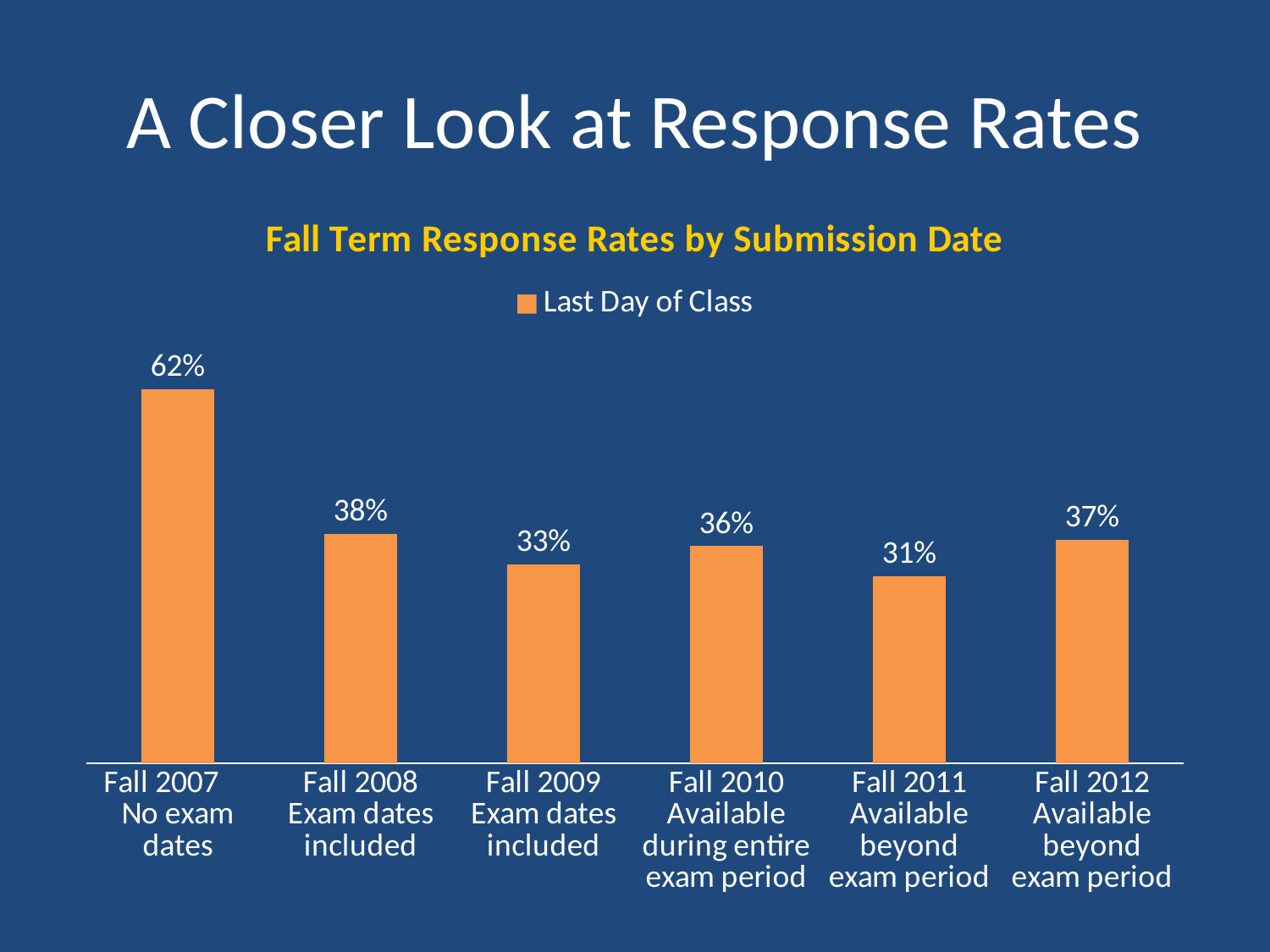
What is the response rate for Fall 2007? 62% What type of chart is shown? Bar chart Which has a higher response rate, Fall 2009 or Fall 2010? Fall 2010 Which fall term has the highest response rate? Fall 2007 What is the response rate for Fall 2010? 36% What is the response rate for Fall 2011? 31% How many fall terms are shown in the chart? 6 Which fall term has the lowest response rate? Fall 2011 What is the difference between the Fall 2007 and Fall 2008 response rates? 24% What is the title of the chart? Fall Term Response Rates by Submission Date How many series does the legend list? 1 What is the difference between the Fall 2012 and Fall 2011 response rates? 6%